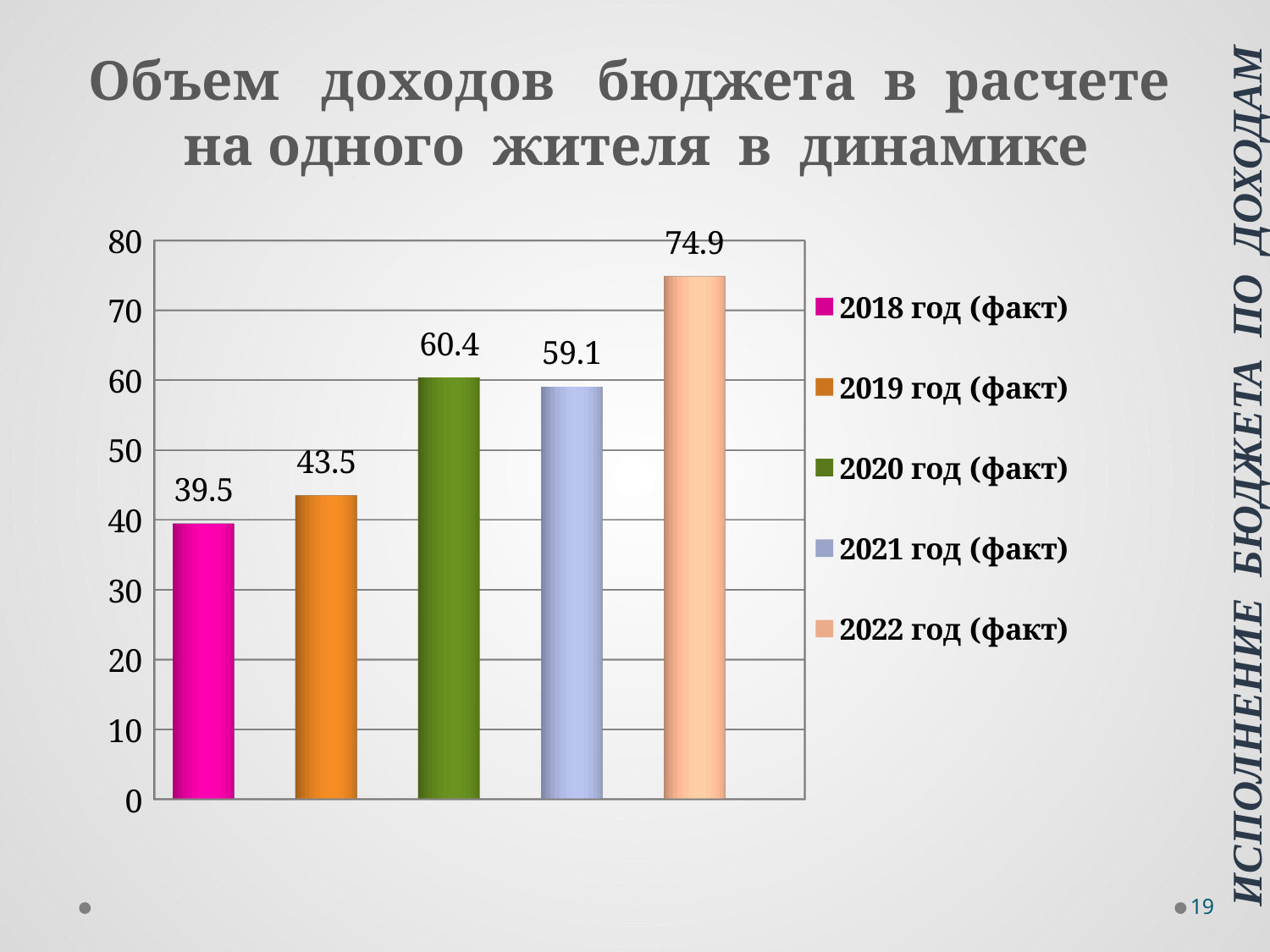
Which year has the lowest value? 2018 год (факт) What is the difference between the values for 2019 год (факт) and 2018 год (факт)? 4 What is the value for 2018 год (факт)? 39.5 What is the difference between the values for 2022 год (факт) and 2021 год (факт)? 15.8 Is the value for 2019 год (факт) greater or less than 50? less What is the value for 2020 год (факт)? 60.4 Which is larger, the value for 2020 год (факт) or 2021 год (факт)? 2020 год (факт) How many entries does the legend list? 5 Which year has the highest value? 2022 год (факт) What is the value for 2022 год (факт)? 74.9 How many bars are plotted in the chart? 5 What kind of chart is shown on the slide? bar chart